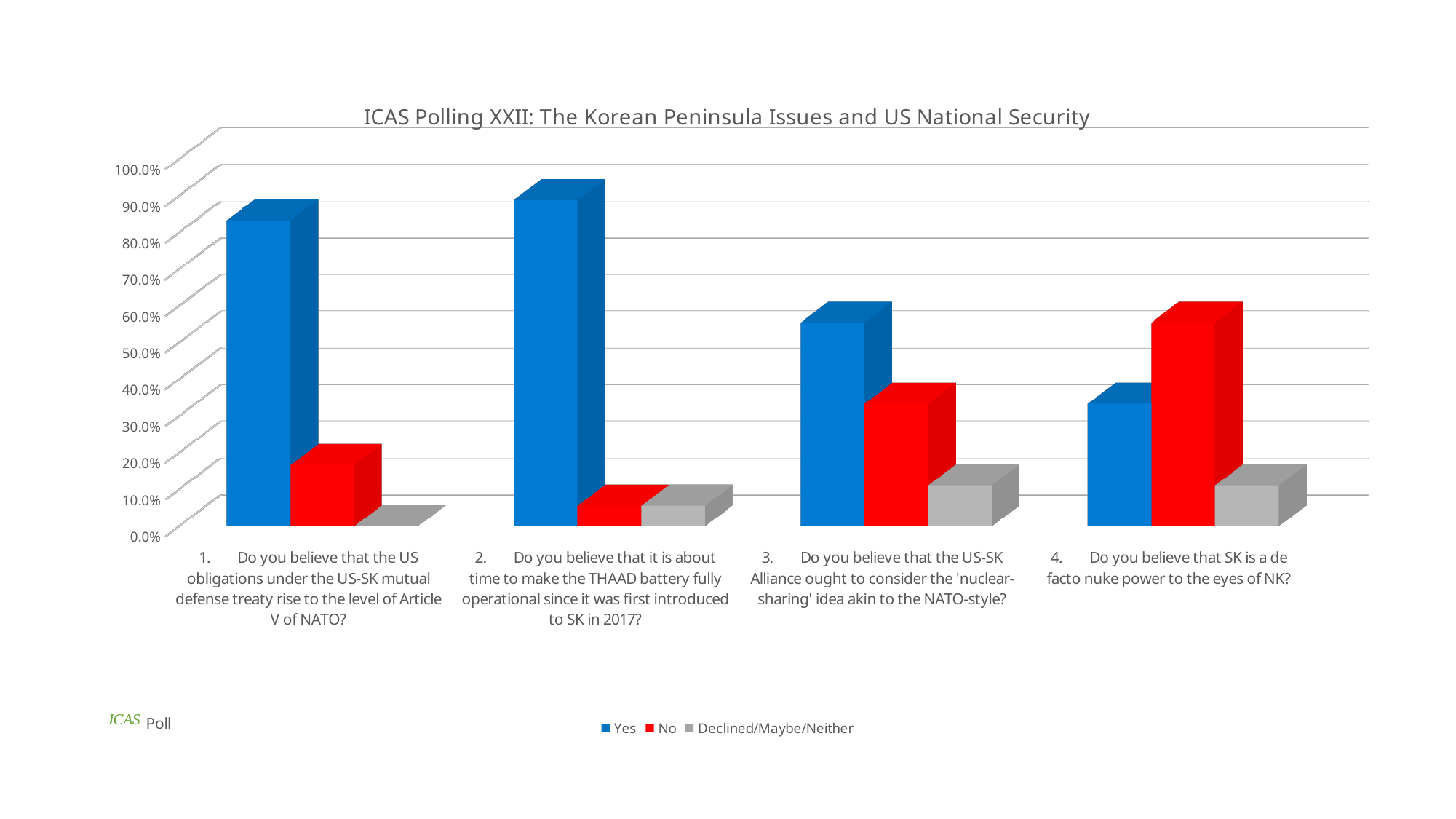
Which poll question has the highest 'Yes' value? 2. Do you believe that it is about time to make the THAAD battery fully operational since it was first introduced to SK in 2017? Which colour represents the 'No' series in the legend? red Which poll question has the lowest 'Yes' value? 4. Do you believe that SK is a de facto nuke power to the eyes of NK? How many poll questions (categories) are plotted on the x axis? 4 Which poll question has the highest 'No' value? 4. Do you believe that SK is a de facto nuke power to the eyes of NK? For question 4 (SK as a de facto nuke power), which is larger, the 'Yes' value or the 'No' value? No Is the 'No' value for question 2 (THAAD battery fully operational) greater or less than 20.0%? less What is the title of the chart? ICAS Polling XXII: The Korean Peninsula Issues and US National Security How many series does the legend list? 3 What kind of chart is shown on the slide? bar chart Is the 'Yes' value for question 1 (US obligations under the US-SK mutual defense treaty) greater or less than 70.0%? greater For question 3 (nuclear-sharing idea), which is larger, the 'Yes' value or the 'No' value? Yes